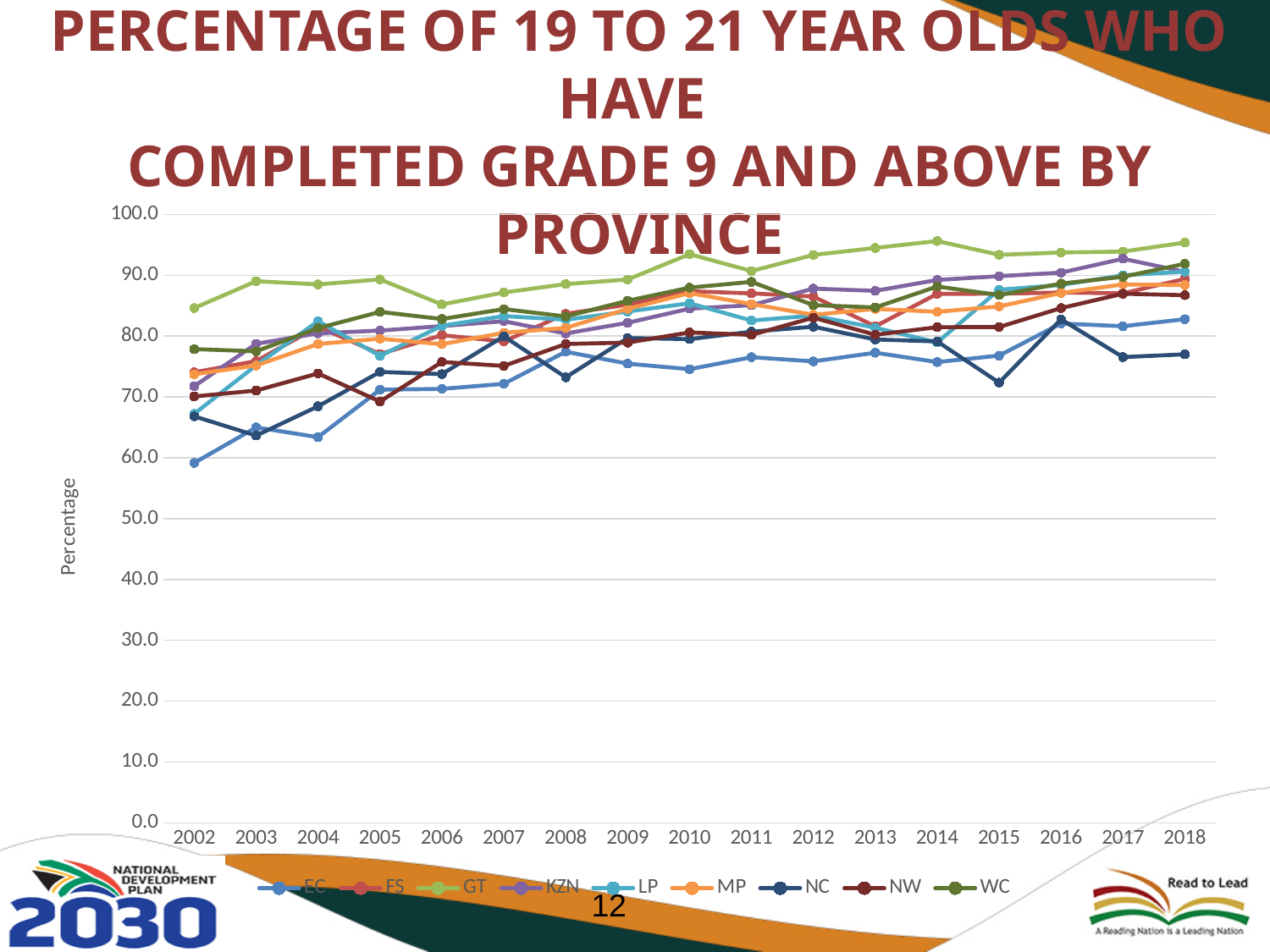
How many years are plotted along the x axis? 17 Which province has the highest value in 2018? GT Which is larger in 2010, the value for GT or the value for EC? GT Is the value for NC in 2015 greater or less than 80? less Which province has the lowest value in 2018? NC What is the label on the vertical axis? Percentage How many series does the legend list? 9 Which province has the lowest value in 2002? EC Is the value for GT in 2014 greater or less than 90? greater Does the GT line generally rise or fall from 2002 to 2018? rise What type of chart is shown on the slide? line chart Is the value for EC in 2002 greater or less than 70? less